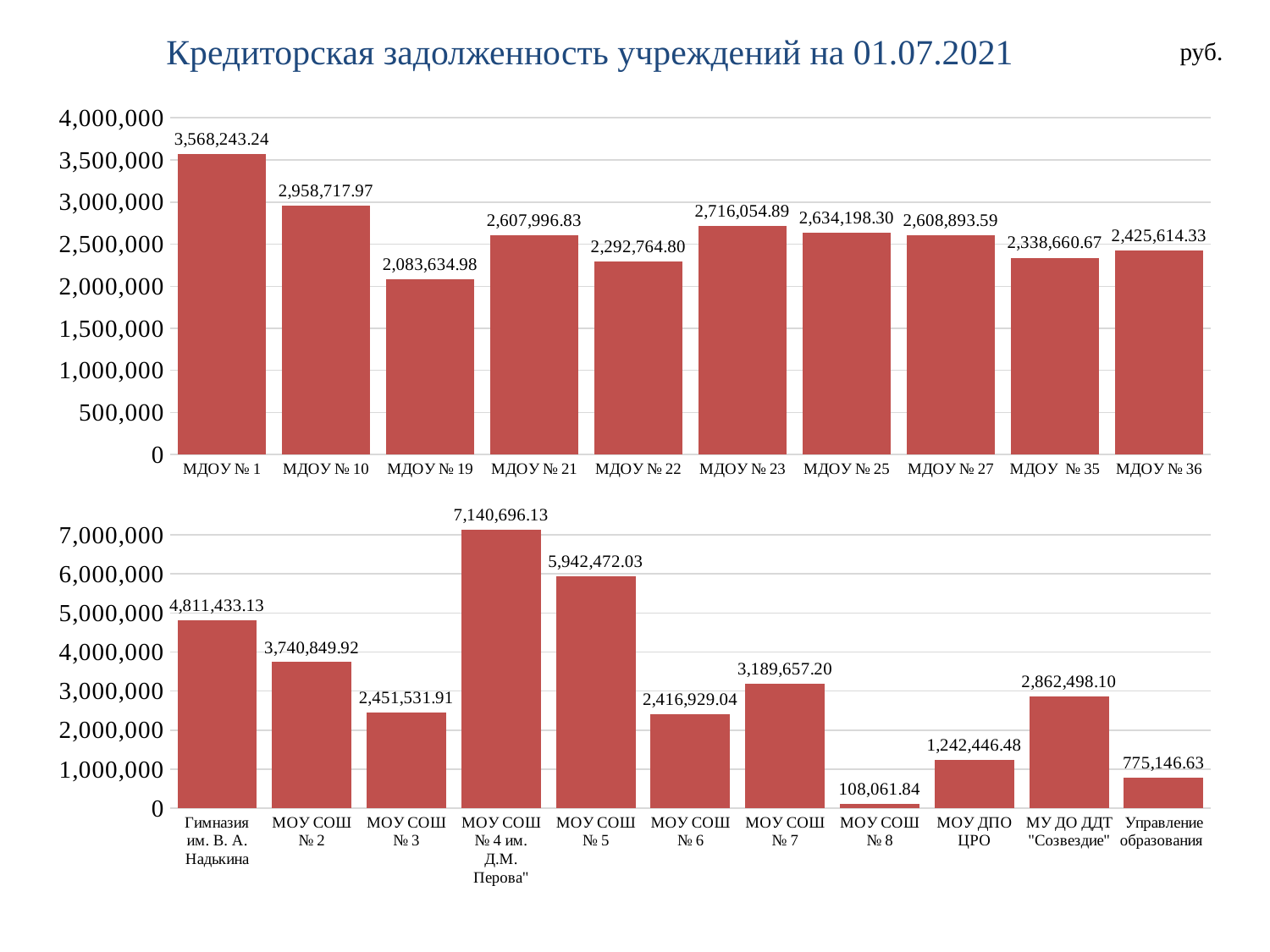
In the top chart, what is the value for МДОУ № 1? 3,568,243.24 In the bottom chart, what is the difference between the values for МОУ СОШ № 4 им. Д.М. Перова and МОУ СОШ № 5? 1,198,224.10 In the top chart, how many categories are shown? 10 In the top chart, what is the value for МДОУ № 22? 2,292,764.80 In the bottom chart, which is larger: the value for МОУ СОШ № 2 or the value for МОУ СОШ № 7? МОУ СОШ № 2 In the top chart, what is the difference between the values for МДОУ № 1 and МДОУ № 19? 1,484,608.26 In the top chart, which category has the highest value? МДОУ № 1 In the bottom chart, how many categories are shown? 11 In the bottom chart, which category has the highest value? МОУ СОШ № 4 им. Д.М. Перова In the bottom chart, what is the value for МОУ СОШ № 8? 108,061.84 What type of chart is the bottom chart? Bar chart In the top chart, which category has the lowest value? МДОУ № 19